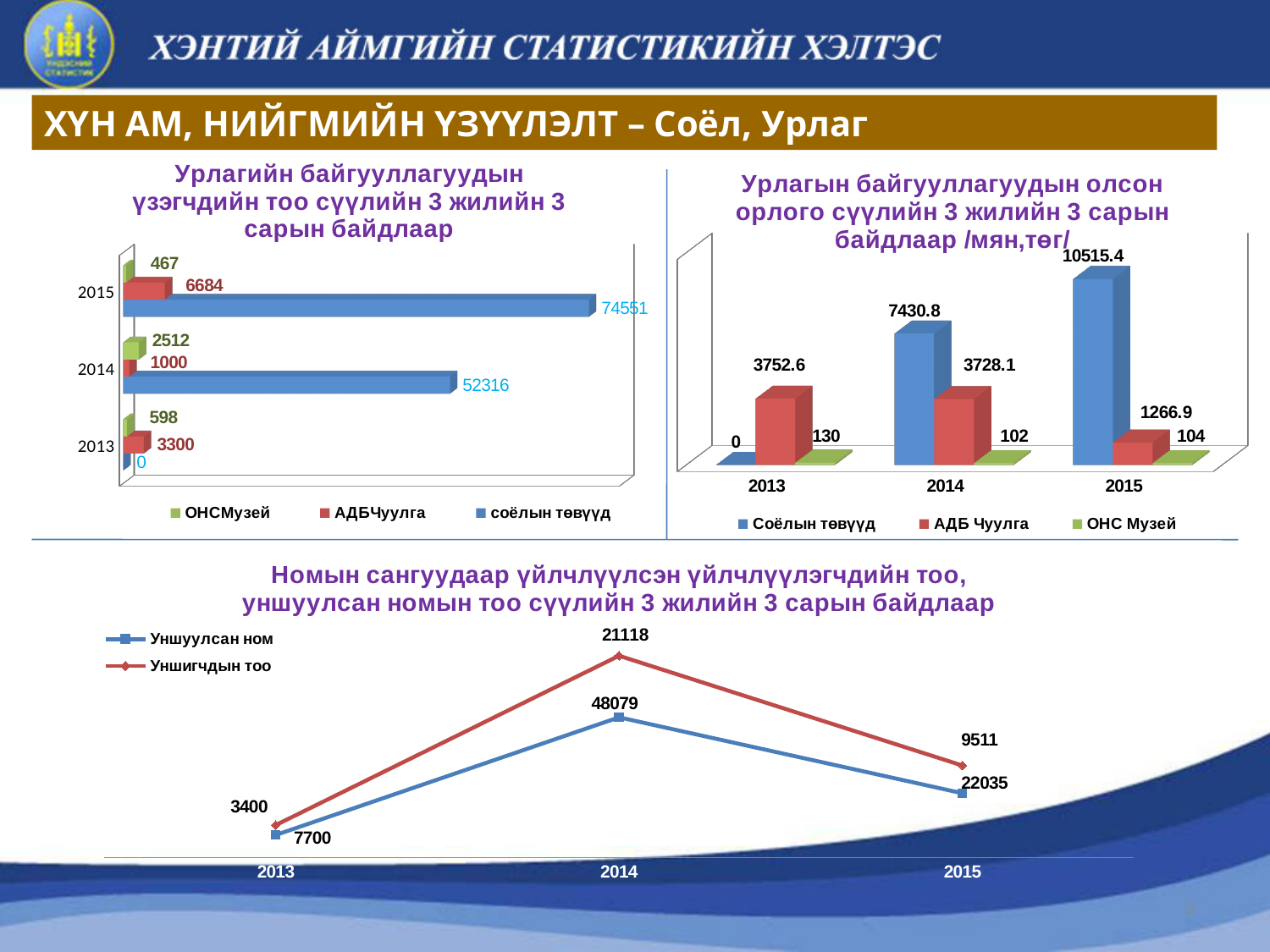
In the top-left chart (Урлагийн байгууллагуудын үзэгчдийн тоо), what is the value for АДБЧуулга in 2013? 3300 In the bottom chart (Номын сангуудаар үйлчлүүлсэн үйлчлүүлэгчдийн тоо), how many years are shown on the x axis? 3 In the top-right chart (Урлагын байгууллагуудын олсон орлого), what is the value for АДБ Чуулга in 2013? 3752.6 In the top-right chart (Урлагын байгууллагуудын олсон орлого), what is the value for Соёлын төвүүд in 2015? 10515.4 In the top-left chart (Урлагийн байгууллагуудын үзэгчдийн тоо), which year has the highest value for ОНСМузей? 2014 In the top-left chart (Урлагийн байгууллагуудын үзэгчдийн тоо), what is the difference between the соёлын төвүүд values for 2015 and 2014? 22235 In the top-right chart (Урлагын байгууллагуудын олсон орлого), how many series does the legend list? 3 In the top-left chart (Урлагийн байгууллагуудын үзэгчдийн тоо), what is the value for соёлын төвүүд in 2015? 74551 What type of chart is the top-left chart (Урлагийн байгууллагуудын үзэгчдийн тоо)? Bar chart In the top-right chart (Урлагын байгууллагуудын олсон орлого), does the value for Соёлын төвүүд rise or fall from 2013 to 2015? Rise In the bottom chart (Номын сангуудаар үйлчлүүлсэн үйлчлүүлэгчдийн тоо), what is the value for Уншуулсан ном in 2014? 48079 In the top-right chart (Урлагын байгууллагуудын олсон орлого), which year has the lowest value for ОНС Музей? 2014